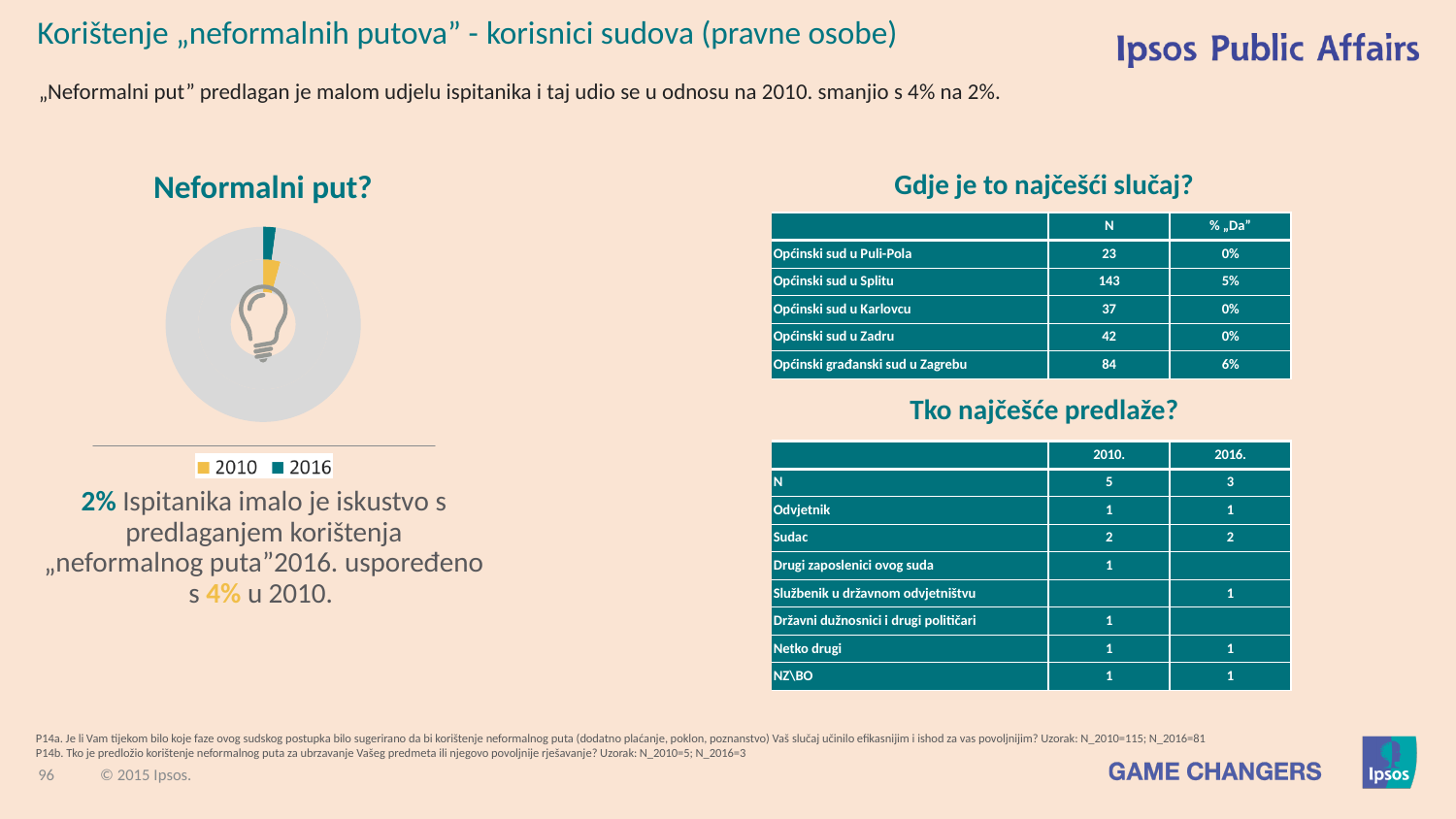
What are the two legend entries of the "Neformalni put?" chart? 2010 and 2016 In the "Neformalni put?" chart, what share of respondents had experience with an informal route in 2010? 4% What kind of chart is shown under the heading "Neformalni put?"? doughnut chart How many entries does the legend of the "Neformalni put?" chart list? 2 In the "Neformalni put?" chart, which colour represents 2010? yellow In the "Neformalni put?" chart, by how many percentage points did the share fall from 2010 to 2016? 2 percentage points In the table "Gdje je to najčešći slučaj?", what is N for Općinski sud u Splitu? 143 In the "Neformalni put?" chart, which year has the larger share, 2010 or 2016? 2010 In the table "Tko najčešće predlaže?", what is the value for Sudac in 2016? 2 In the "Neformalni put?" chart, did the share rise or fall from 2010 to 2016? fall In the table "Gdje je to najčešći slučaj?", which court has the highest % "Da"? Općinski građanski sud u Zagrebu In the "Neformalni put?" chart, what share of respondents had experience with an informal route in 2016? 2%